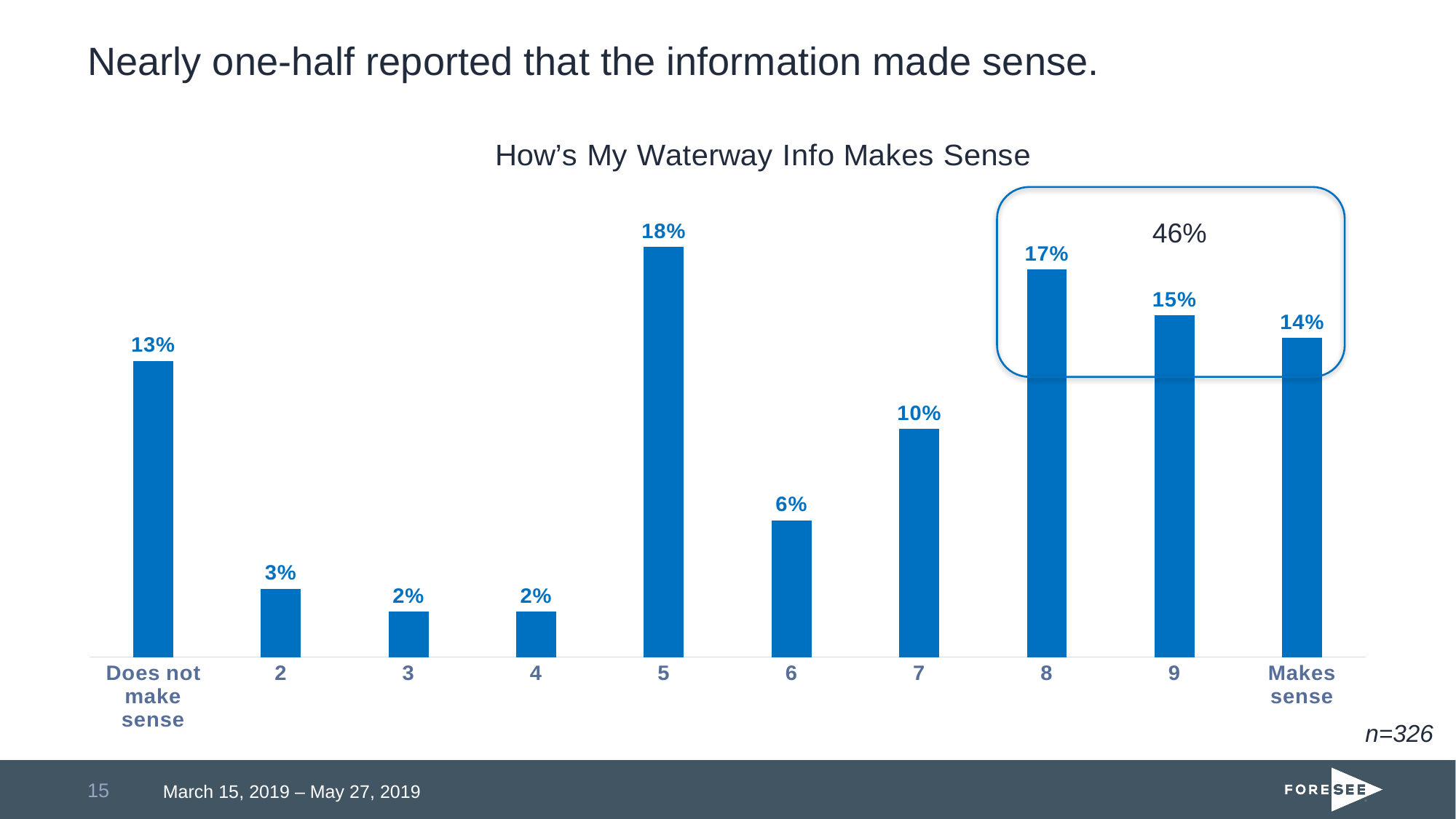
Which category has the highest value? 5 What is the value for the "Does not make sense" category? 13% What is the difference between the values for category 8 and category 6? 11% How many categories are shown on the x axis? 10 What is the value for the "Makes sense" category? 14% What is the value for category 5? 18% What is the combined total of the values for categories 8, 9 and "Makes sense"? 46% What kind of chart is shown on the slide? Bar chart What is the title of the chart? How's My Waterway Info Makes Sense What is the value for category 7? 10% Which is larger, the value for category 9 or the value for "Does not make sense"? 9 What sample size (n) is shown on the slide? n=326